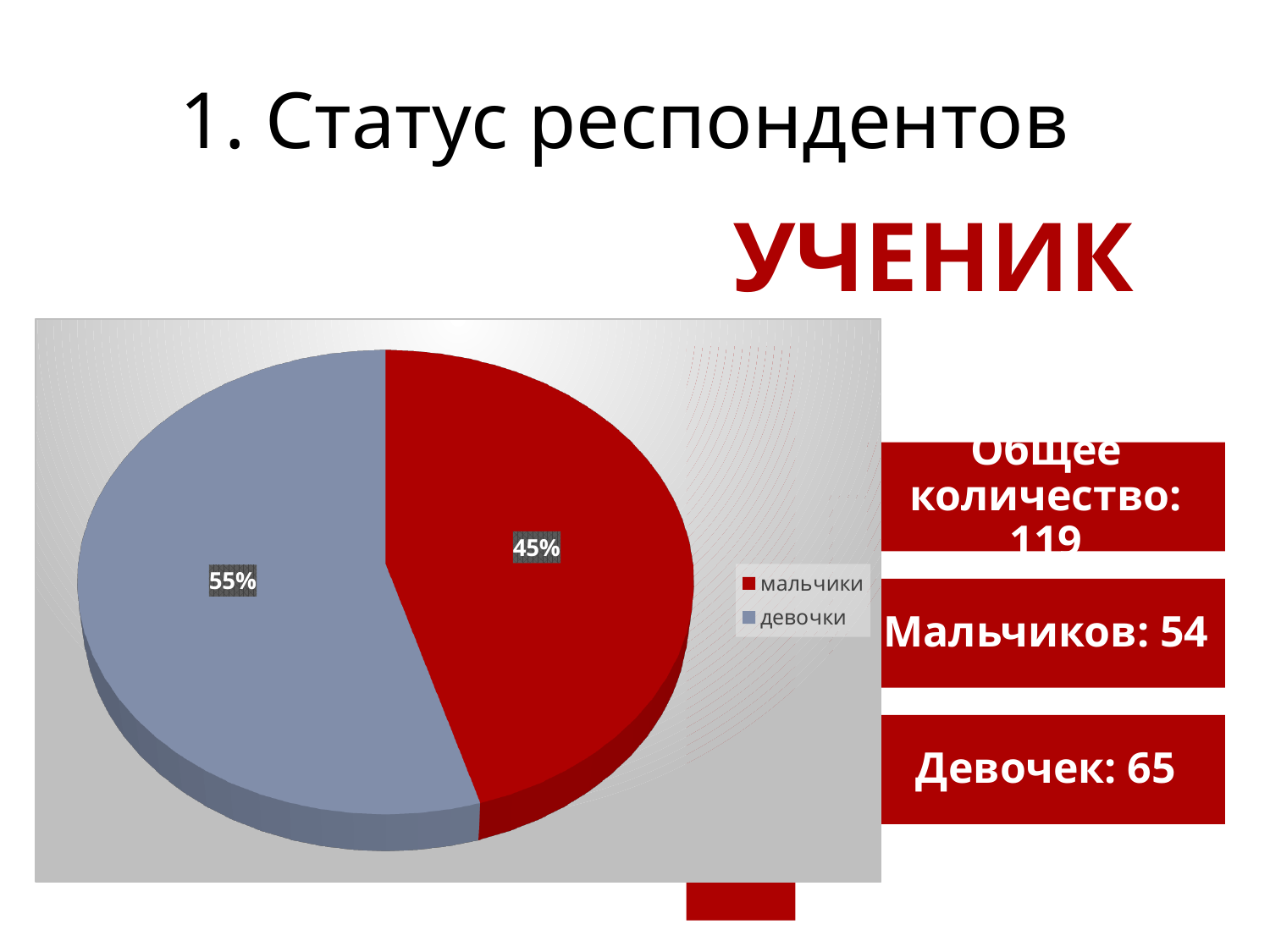
What percentage of the pie is labelled for мальчики? 45% Is the share for мальчики greater or less than 50%? less How many slices does the pie chart have? 2 What kind of chart is shown on the slide? pie chart Which slice of the pie is the smallest? мальчики What colour is the мальчики slice? red What colour is the девочки slice? grey-blue What percentage of the pie is labelled for девочки? 55% How many entries does the legend list? 2 Which slice of the pie is the largest? девочки What is the difference in percentage points between the девочки slice and the мальчики slice? 10 Which slice is larger, мальчики or девочки? девочки